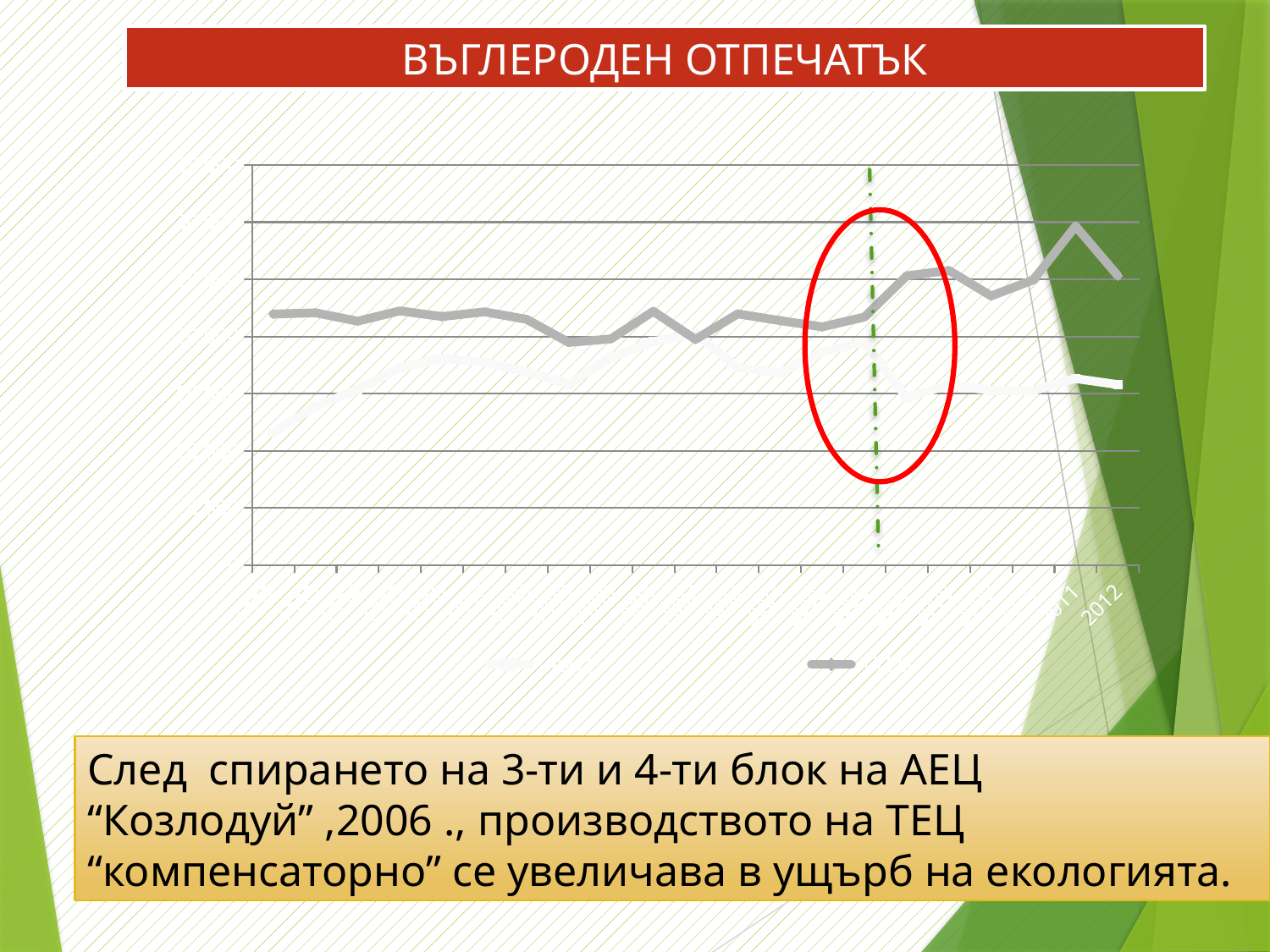
Does the grey line rise or fall between the green dashed vertical line and the 2011 peak? rises What kind of chart is shown on the slide? line chart What is the last year label shown on the x axis of the chart? 2012 How many data series are plotted in the chart? 2 Which line reaches the highest point on the chart, the grey line or the white line? grey line Does the white line rise or fall immediately after the green dashed vertical line? falls What is the title shown in the red banner above the chart? ВЪГЛЕРОДЕН ОТПЕЧАТЪК At the right end of the chart (2012), which line is higher, the grey line or the white line? grey line